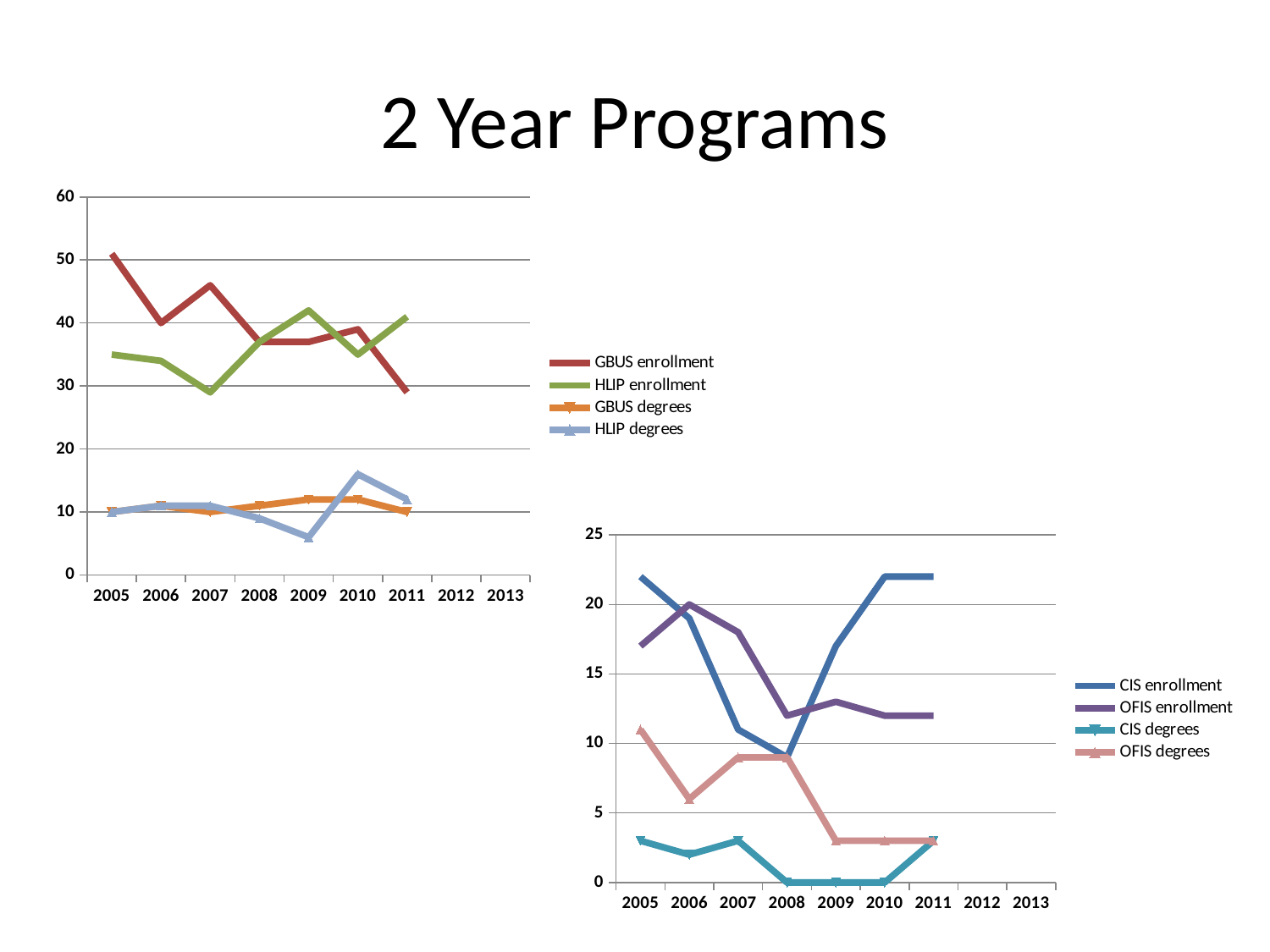
In the chart on the right, what is the value for OFIS enrollment in 2006? 20 In the chart on the right, what is the value for CIS degrees in 2008? 0 What kind of chart is the chart on the left of the slide? line chart In the chart on the left, is the value for GBUS enrollment in 2005 greater or less than 40? greater In the chart on the right, does OFIS enrollment rise or fall from 2006 to 2011? fall In the chart on the right, how many years are labeled on the x axis? 9 In the chart on the left, how many series does the legend list? 4 In the chart on the right, is the value for CIS enrollment in 2010 greater or less than 20? greater In the chart on the left, which series has the highest value in 2005? GBUS enrollment In the chart on the right, how many series does the legend list? 4 In the chart on the left, is the value for HLIP degrees in 2009 greater or less than 10? less In the chart on the right, which is larger in 2005, CIS enrollment or OFIS enrollment? CIS enrollment